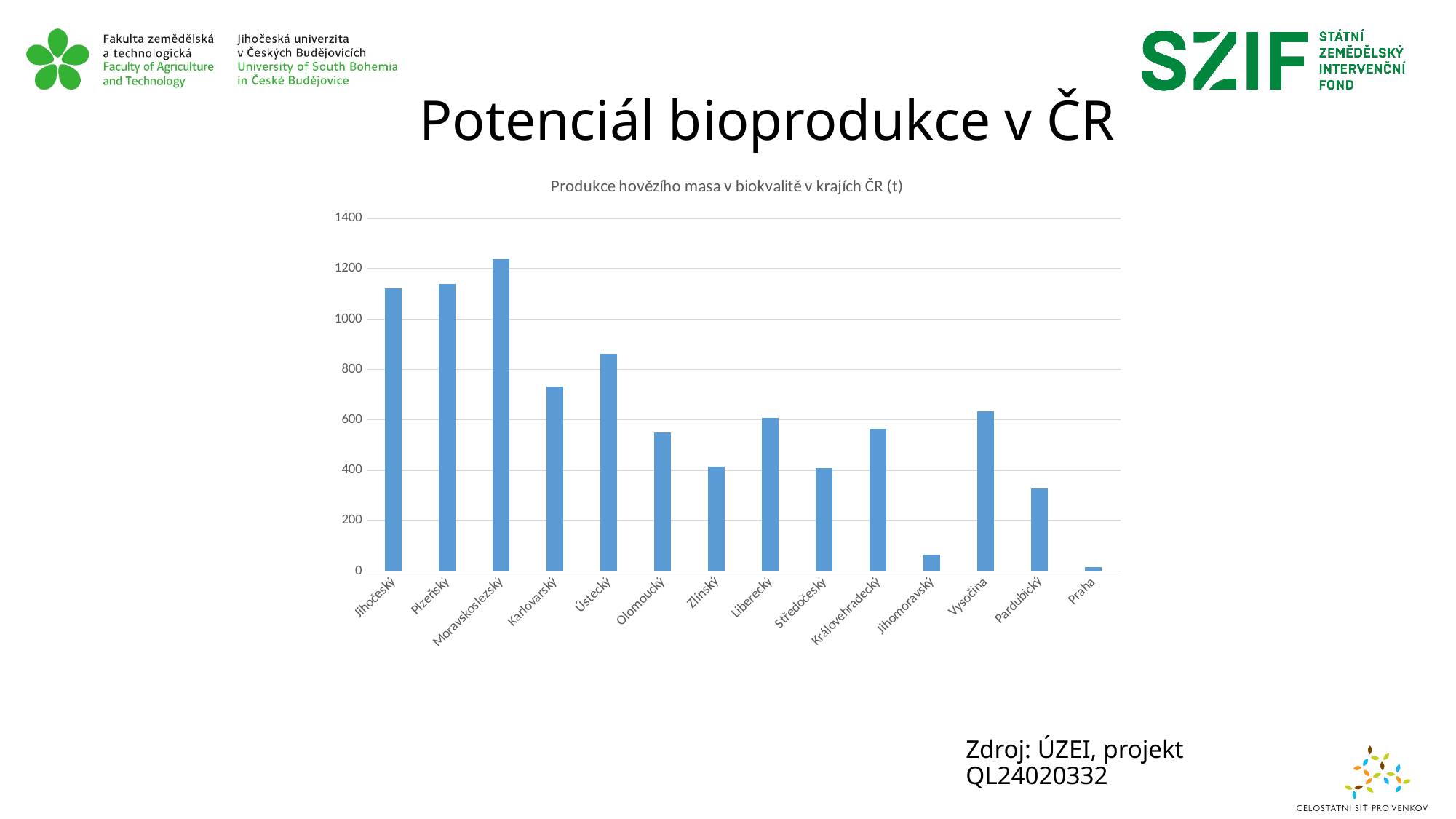
Which has the larger value, Karlovarský or Ústecký? Ústecký Is the value for Moravskoslezský greater or less than 1200? greater What is the title of the chart? Produkce hovězího masa v biokvalitě v krajích ČR (t) What kind of chart is shown on the slide? bar chart Is the value for Ústecký greater or less than 1000? less Which region has the lowest value on the chart? Praha How many regions (categories) are plotted on the chart? 14 Is the value for Karlovarský greater or less than 600? greater Which has the larger value, Vysočina or Pardubický? Vysočina Which region has the highest value on the chart? Moravskoslezský